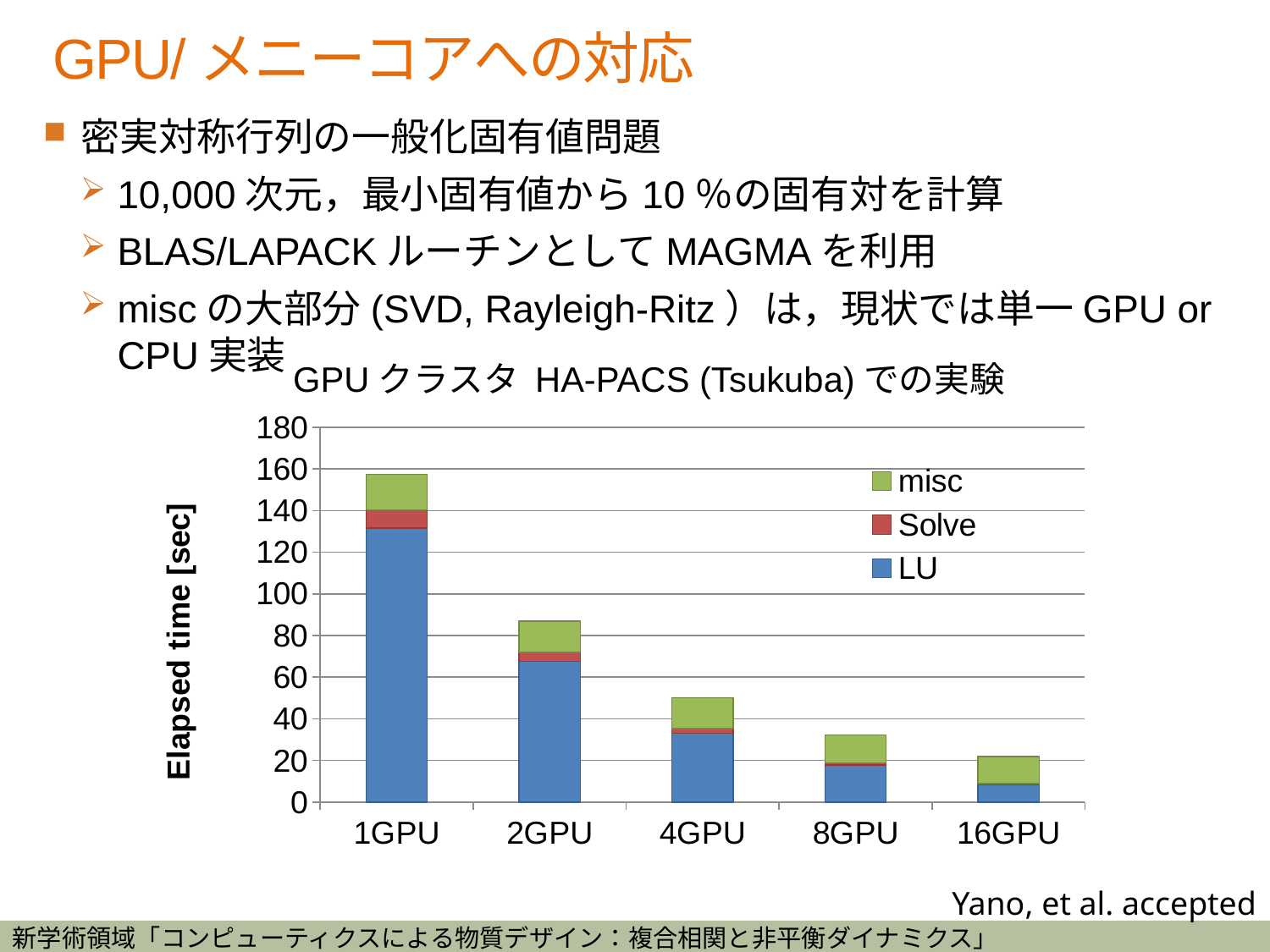
Is the total elapsed time for 1GPU greater or less than 140? greater Is the total elapsed time for 2GPU greater or less than 100? less Does the total elapsed time rise or fall as the number of GPUs increases along the x axis? fall How many GPU configurations (categories) are shown on the x axis? 5 How many series does the legend list? 3 Which has a larger total elapsed time, 2GPU or 8GPU? 2GPU Which GPU configuration has the lowest total elapsed time? 16GPU Which GPU configuration has the highest total elapsed time? 1GPU What kind of chart is shown on the slide? stacked bar chart Is the LU portion for 1GPU greater or less than 120? greater What is the label of the y axis? Elapsed time [sec]